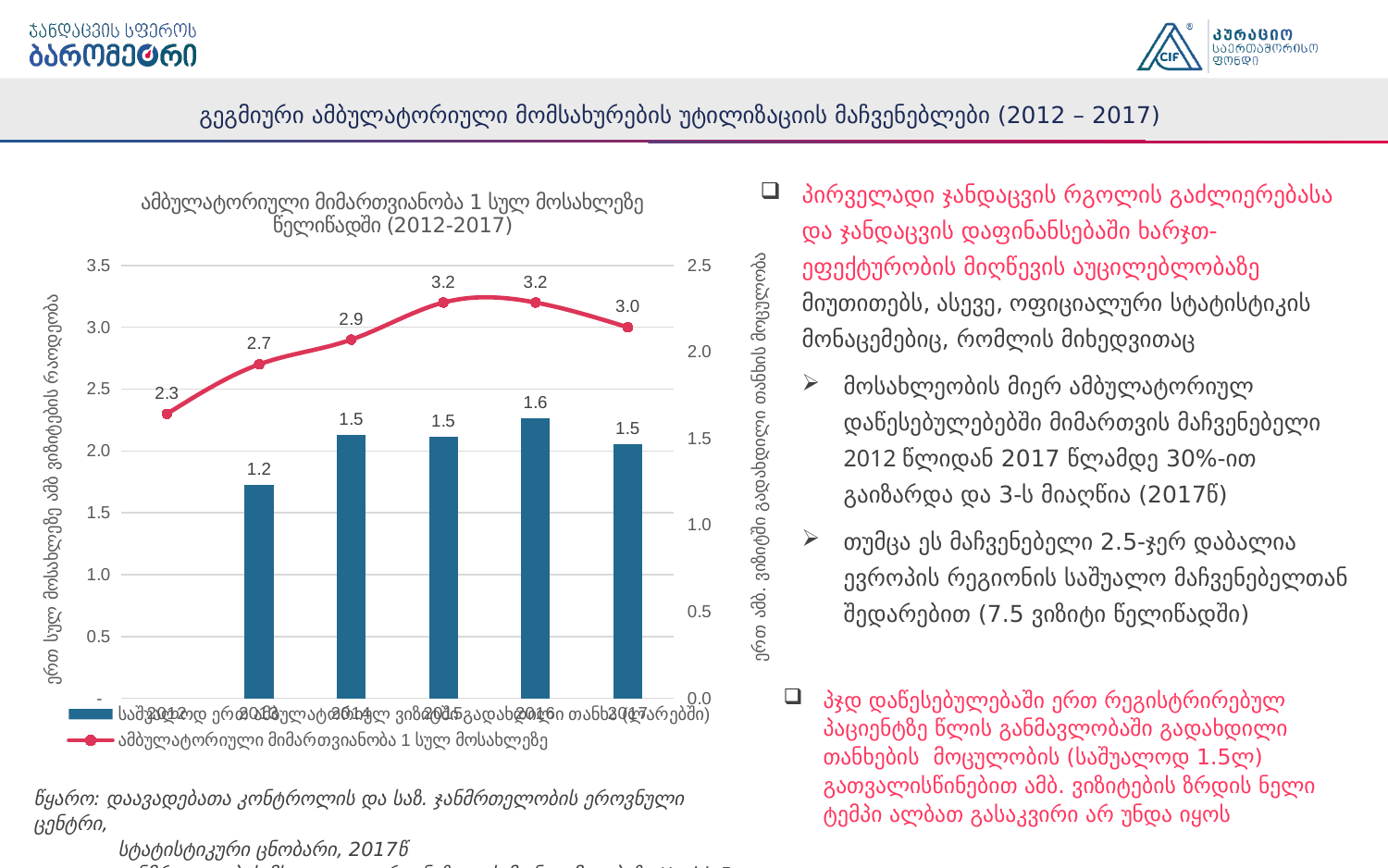
What is the difference between the line series values for 2017 and 2012? 0.7 What kind of chart is shown on the slide? Combination bar and line chart What is the value of the bar for 2016? 1.6 Does the line series rise or fall from 2012 to 2015? Rises What is the value of the line series for 2017? 3.0 How many years are shown on the x axis of the chart? 6 Which year has the larger line series value, 2013 or 2014? 2014 Which year has the highest bar value? 2016 What is the value of the bar for 2013? 1.2 What is the value of the line series (ამბულატორიული მიმართვიანობა 1 სულ მოსახლეზე) for 2012? 2.3 How many series does the chart's legend list? 2 Which year has the lowest value on the line series? 2012